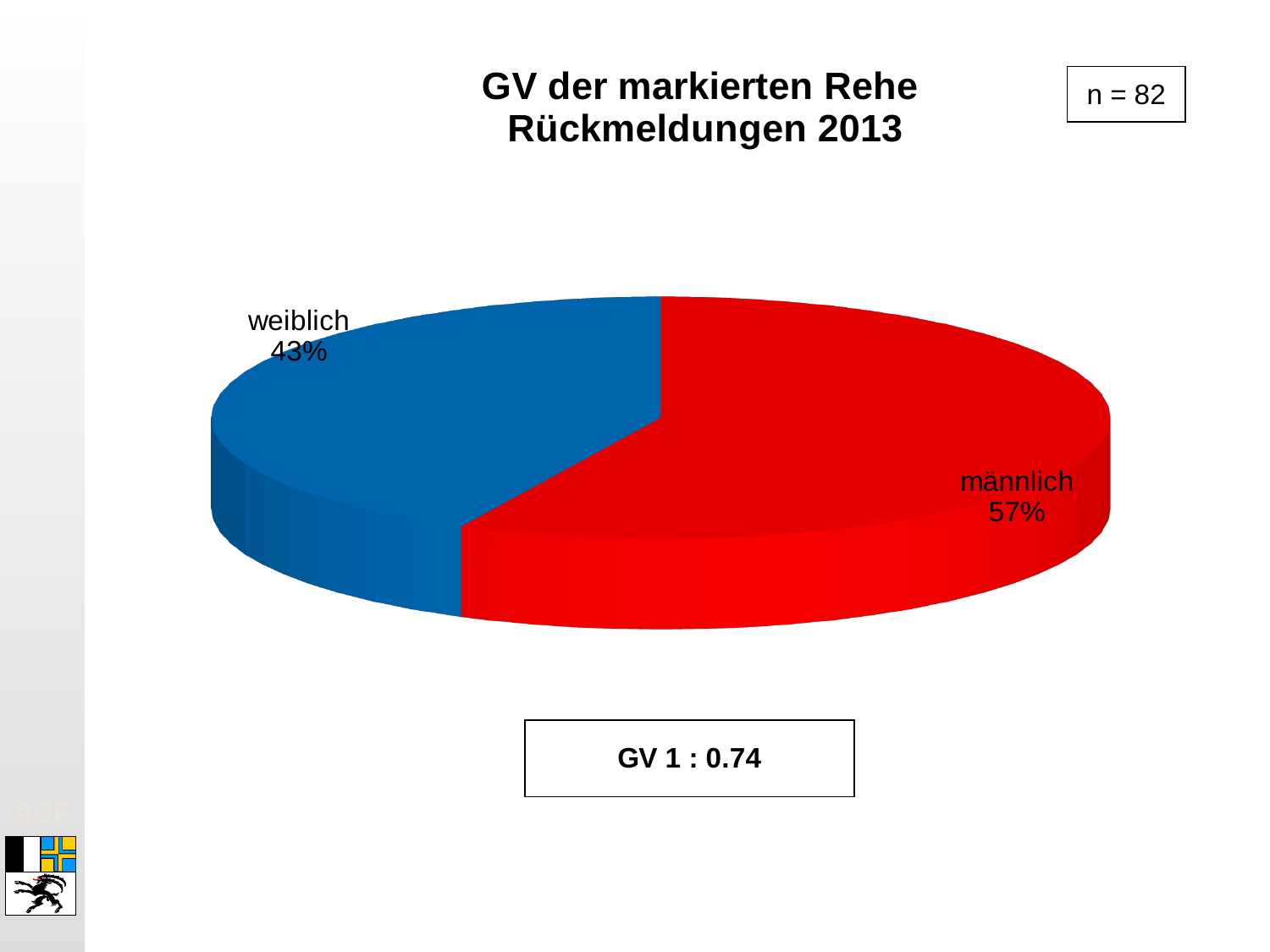
Is the share for weiblich greater or less than 50%? less Which is larger, the männlich slice or the weiblich slice? männlich Which slice is the largest in the pie chart? männlich How many slices does the pie chart have? 2 What colour is the männlich slice? red Which slice is the smallest in the pie chart? weiblich What is the title of the chart? GV der markierten Rehe Rückmeldungen 2013 What is the difference in percentage points between the männlich and weiblich slices? 14 What kind of chart is shown on the slide? pie chart What share of the pie does the männlich slice represent? 57% What share of the pie does the weiblich slice represent? 43%